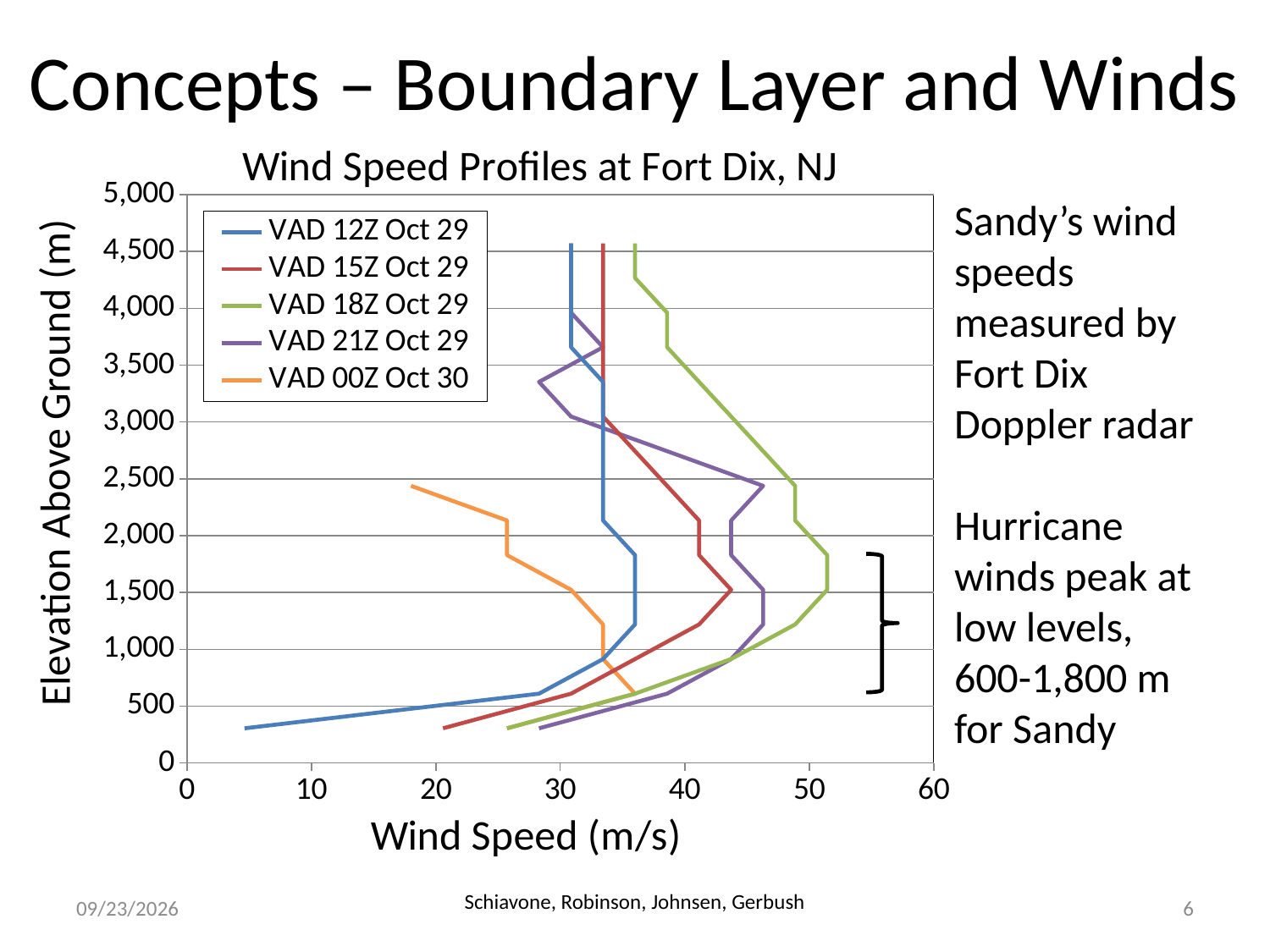
Is the wind speed for VAD 00Z Oct 30 at 2,500 m greater or less than 20? less Is the wind speed for VAD 12Z Oct 29 at its lowest plotted elevation greater or less than 10? less Which series reaches the highest wind speed anywhere on the chart? VAD 18Z Oct 29 At an elevation of 2,500 m, which series has the lowest wind speed? VAD 00Z Oct 30 At an elevation of 1,500 m, which series has the higher wind speed, VAD 18Z Oct 29 or VAD 12Z Oct 29? VAD 18Z Oct 29 Is the wind speed for VAD 21Z Oct 29 at 2,500 m greater or less than 40? greater How many series does the legend list? 5 What is the title of the chart? Wind Speed Profiles at Fort Dix, NJ Which series has the lowest wind speed at the lowest plotted elevation (about 300 m)? VAD 12Z Oct 29 What is the label of the horizontal axis? Wind Speed (m/s) For VAD 12Z Oct 29, does the wind speed increase or decrease as elevation rises from about 300 m to 1,500 m? increase What kind of chart is shown on the slide? line chart